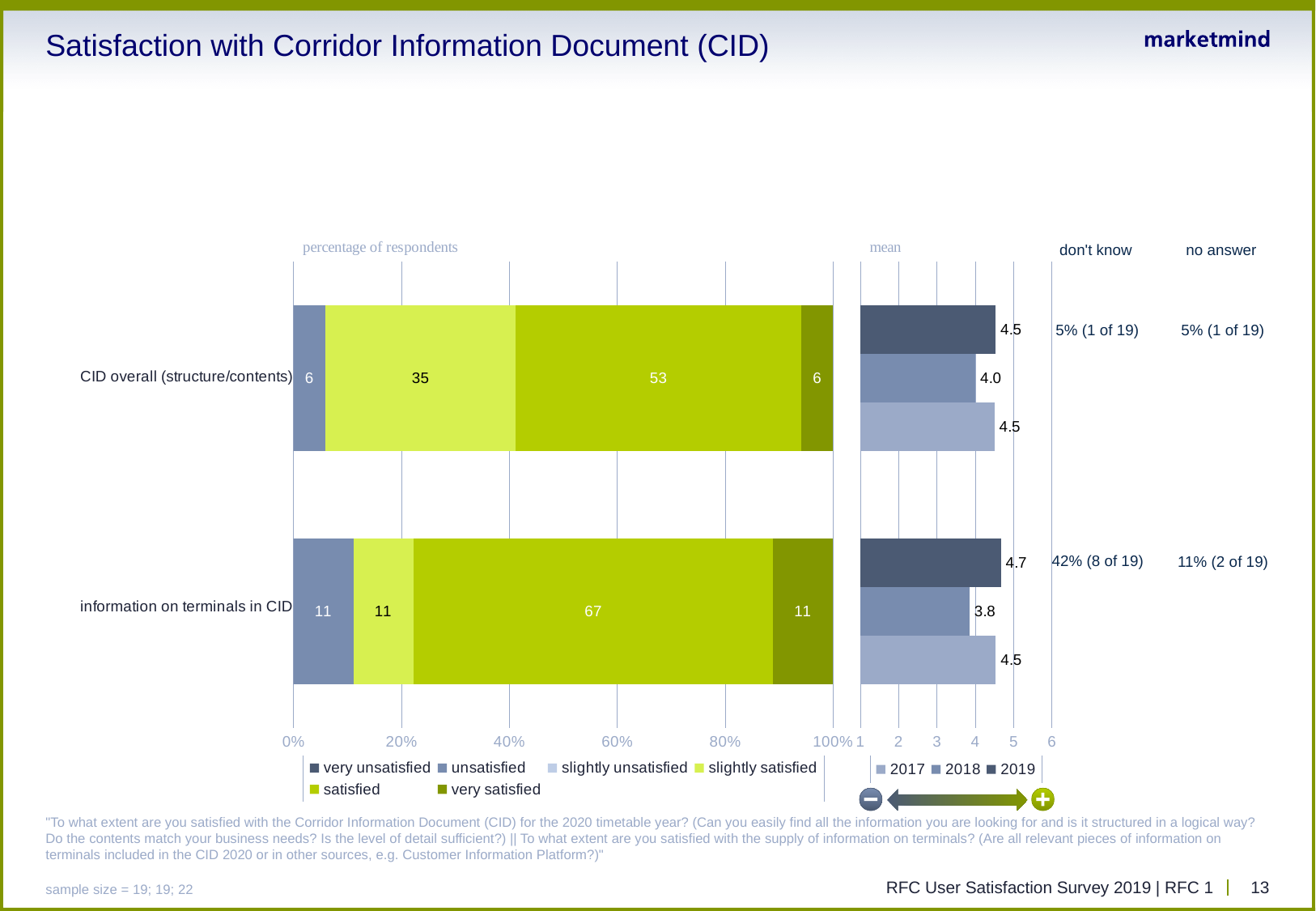
In the percentage of respondents chart, what percentage of respondents were satisfied with CID overall (structure/contents)? 53 In the mean chart, which year has the lowest mean for information on terminals in CID? 2018 In the percentage of respondents chart, what is the difference between the satisfied share for information on terminals in CID and the satisfied share for CID overall (structure/contents)? 14 What kind of chart is the percentage of respondents chart? stacked bar chart In the percentage of respondents chart, what percentage of respondents were slightly satisfied with CID overall (structure/contents)? 35 In the percentage of respondents chart, how many series does the legend list? 6 In the mean chart, what is the difference between the 2019 and 2018 means for information on terminals in CID? 0.9 In the mean chart, what is the 2019 mean for information on terminals in CID? 4.7 In the mean chart, what is the 2018 mean for CID overall (structure/contents)? 4.0 In the percentage of respondents chart, what percentage of respondents were satisfied with information on terminals in CID? 67 In the percentage of respondents chart, which category has the larger very satisfied share, CID overall (structure/contents) or information on terminals in CID? information on terminals in CID In the mean chart, how many series does the legend list? 3